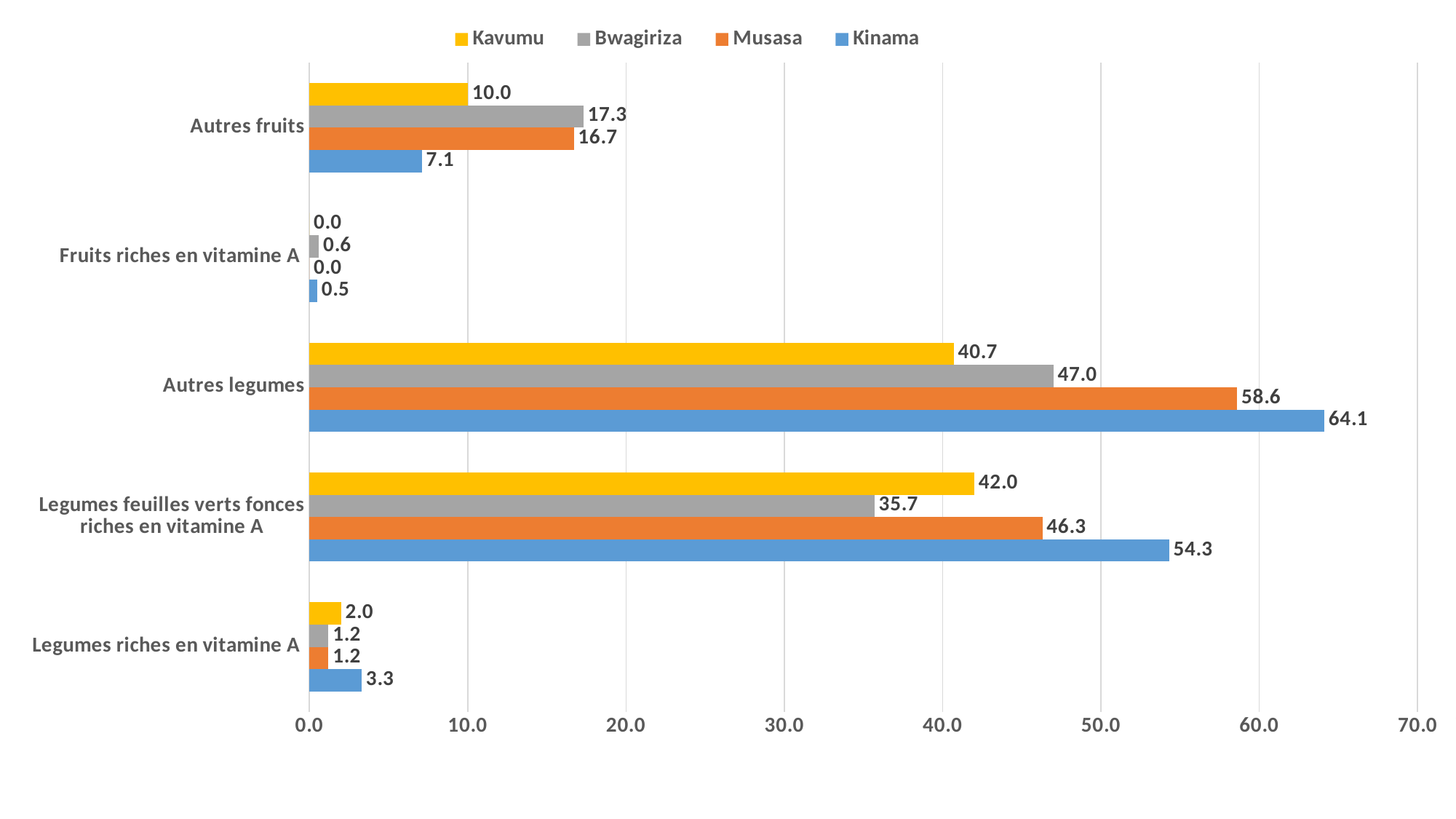
What is the value for Kinama in the Autres legumes category? 64.1 What is the difference between the Kinama and Kavumu values in the Autres legumes category? 23.4 Which series has the highest value in the Autres legumes category? Kinama What is the value for Bwagiriza in the Autres fruits category? 17.3 Which colour represents the Musasa series in the legend? Orange Which series has the lowest value in the Autres fruits category? Kinama How many series does the legend list? 4 Which is larger in the Legumes feuilles verts fonces riches en vitamine A category: Kavumu or Bwagiriza? Kavumu How many categories are shown on the chart? 5 What kind of chart is shown on the slide? Bar chart What is the value for Kavumu in the Fruits riches en vitamine A category? 0.0 What is the value for Musasa in the Legumes feuilles verts fonces riches en vitamine A category? 46.3